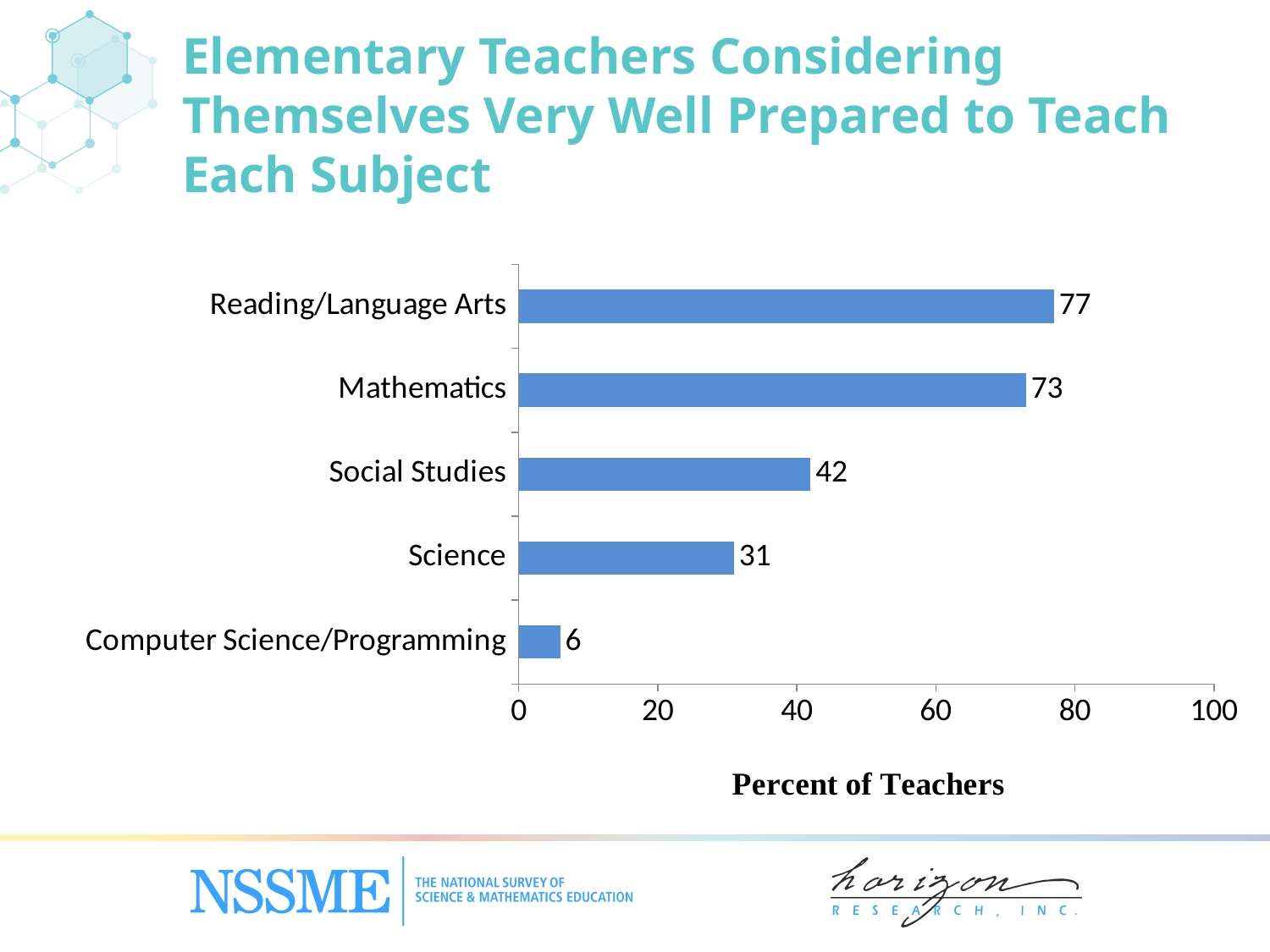
What is the difference between the values for Social Studies and Science? 11 How many subjects are shown in the chart? 5 What is the value for Mathematics? 73 What is the difference between the values for Reading/Language Arts and Mathematics? 4 Which is larger, the value for Science or the value for Social Studies? Social Studies What is the value for Science? 31 What is the value for Social Studies? 42 What kind of chart is shown on the slide? Bar chart Which subject has the lowest percent of teachers considering themselves very well prepared? Computer Science/Programming Which subject has the highest percent of teachers considering themselves very well prepared? Reading/Language Arts What percent of elementary teachers consider themselves very well prepared to teach Reading/Language Arts? 77 What is the value for Computer Science/Programming? 6